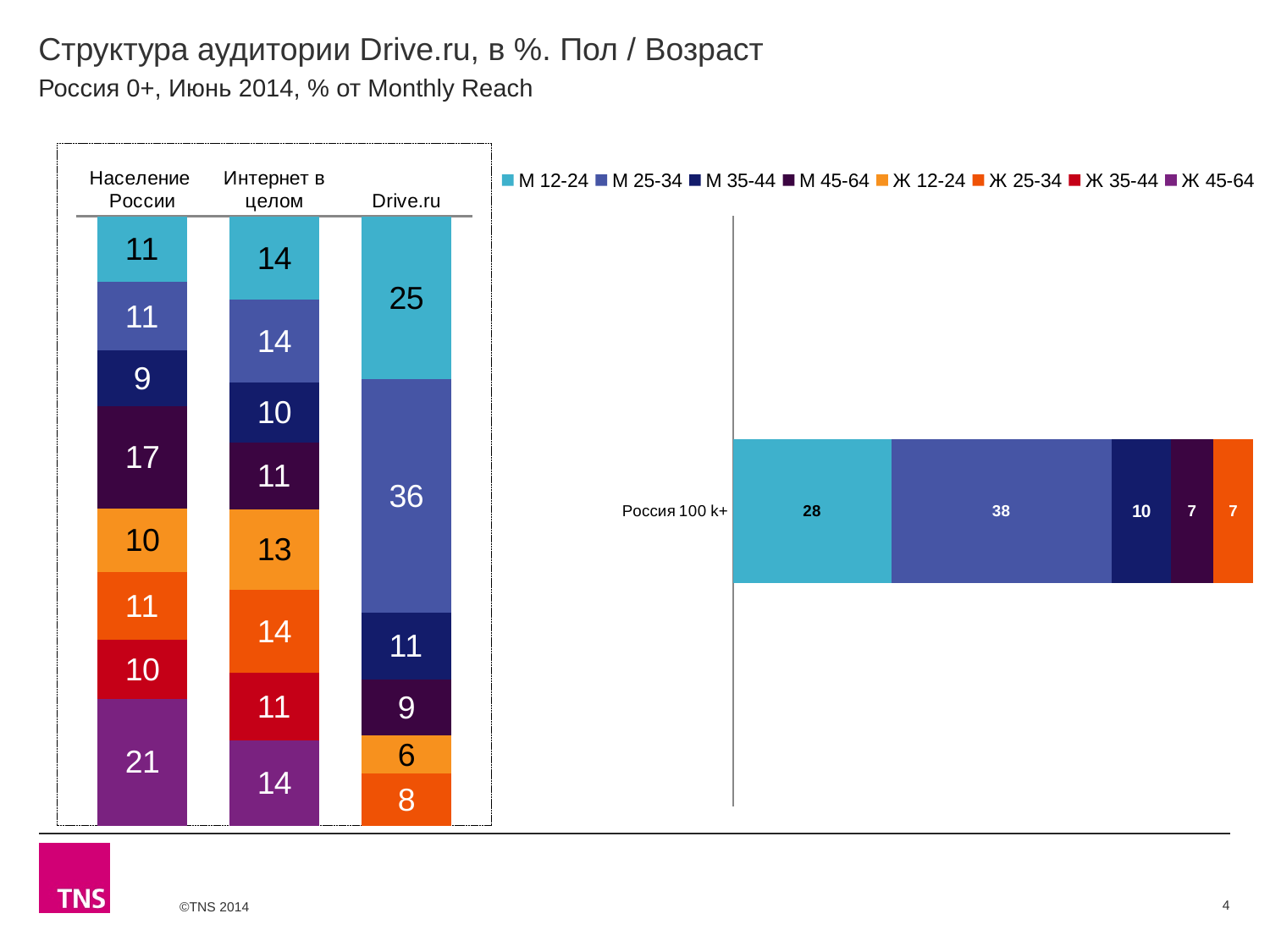
On the left chart, what is the value of the М 35-44 segment for Интернет в целом? 10 On the left chart, what is the value of the М 25-34 segment for Drive.ru? 36 On the left chart, which is larger: the М 45-64 value for Население России or for Drive.ru? Население России On the left chart, which segment of the Drive.ru bar is the largest? М 25-34 On the right chart, what is the value of the М 12-24 segment for Россия 100 k+? 28 How many categories (bars) does the left chart show? 3 On the left chart, which segment of the Drive.ru bar is the smallest? Ж 12-24 What type of chart is the right chart? Stacked bar chart On the left chart, what is the difference between the М 12-24 values for Drive.ru and Население России? 14 On the right chart, what is the value of the М 25-34 segment for Россия 100 k+? 38 How many series does the legend list? 8 On the left chart, what is the value of the Ж 45-64 segment for Население России? 21